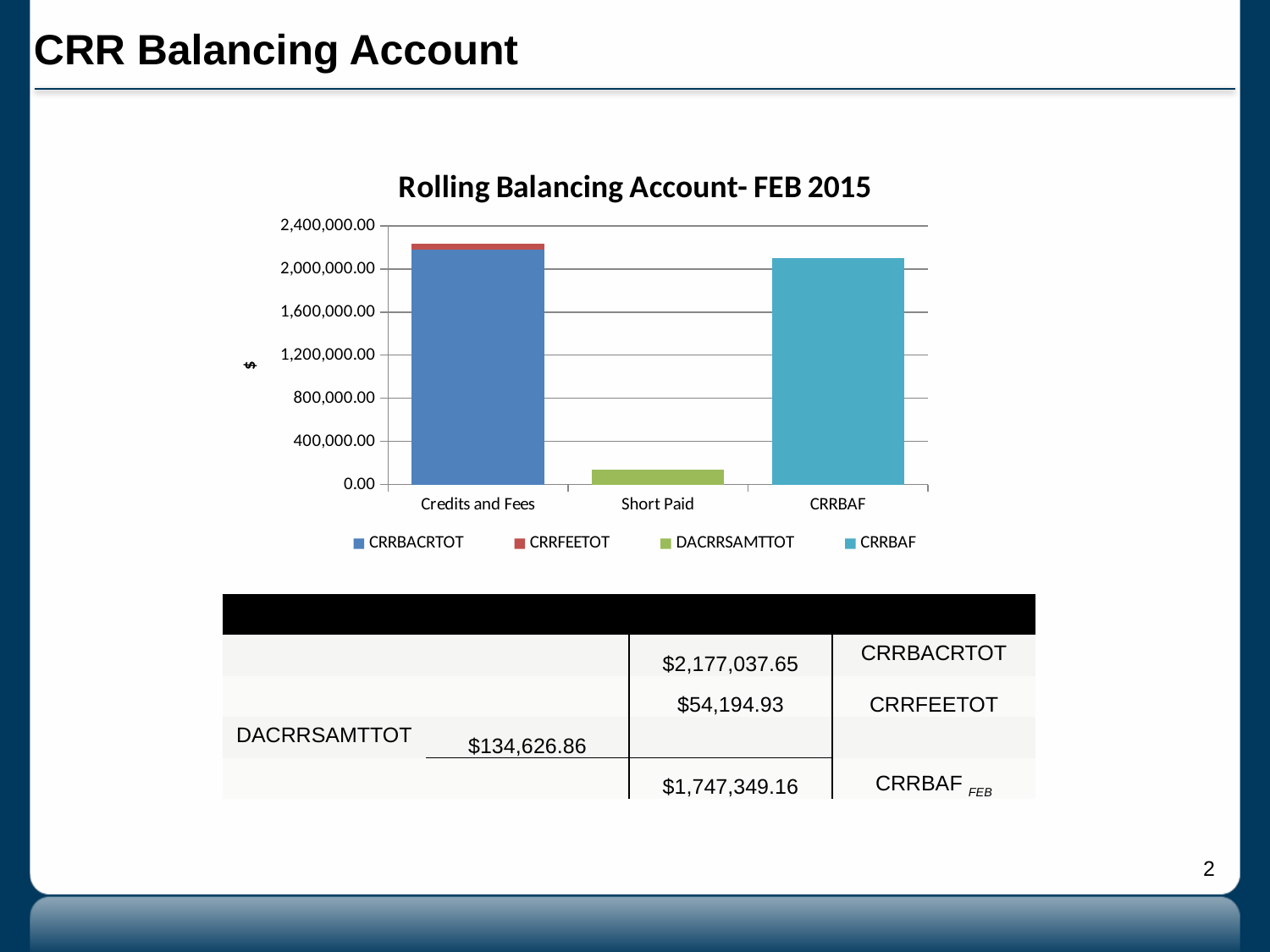
What is the title of the chart? Rolling Balancing Account- FEB 2015 How many series does the chart legend list? 4 Which category has the tallest bar in the chart? Credits and Fees What kind of chart is shown on the slide? bar chart Is the total bar for Credits and Fees greater or less than 2,000,000.00? greater Which category has the lowest bar in the chart? Short Paid What label is shown on the y axis of the chart? $ Is the value for Short Paid greater or less than 400,000.00? less Which is larger, the bar for Short Paid or the bar for CRRBAF? CRRBAF How many categories are shown on the x axis of the chart? 3 Is the value for CRRBAF greater or less than 1,600,000.00? greater